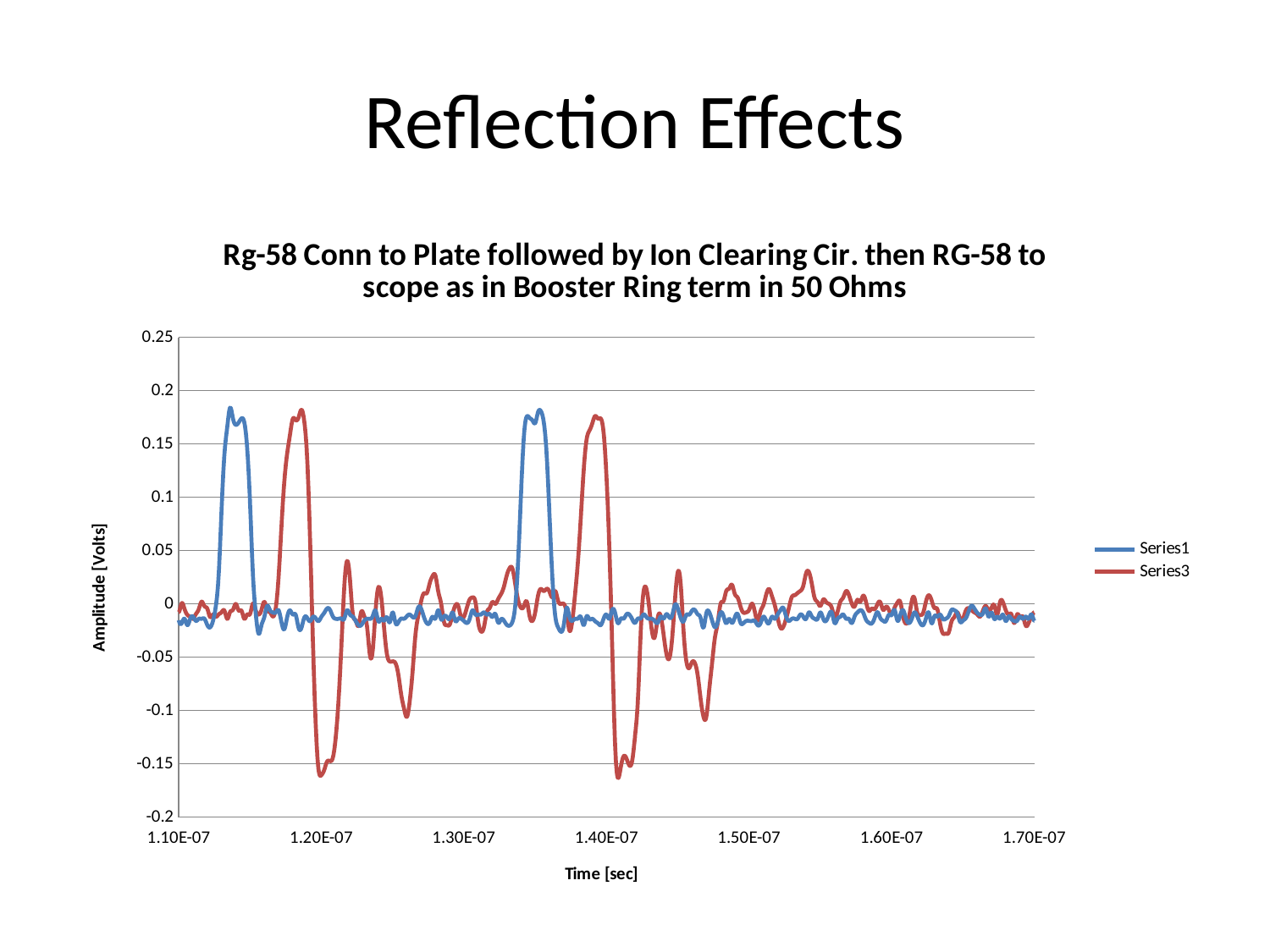
How many series does the legend list? 2 Is the highest peak of Series1 greater or less than 0.15? greater How many labelled tick marks are shown on the Time [sec] axis? 7 What are the names of the series listed in the legend? Series1 and Series3 Is the lowest point of Series3 greater or less than -0.1? less What kind of chart is shown on the slide? Line chart Which series reaches the lowest value on the chart, Series1 or Series3? Series3 What is the minimum value shown on the Amplitude [Volts] axis? -0.2 What is the maximum value shown on the Amplitude [Volts] axis? 0.25 What is the label of the vertical axis? Amplitude [Volts] Is the highest peak of Series3 greater or less than 0.2? less